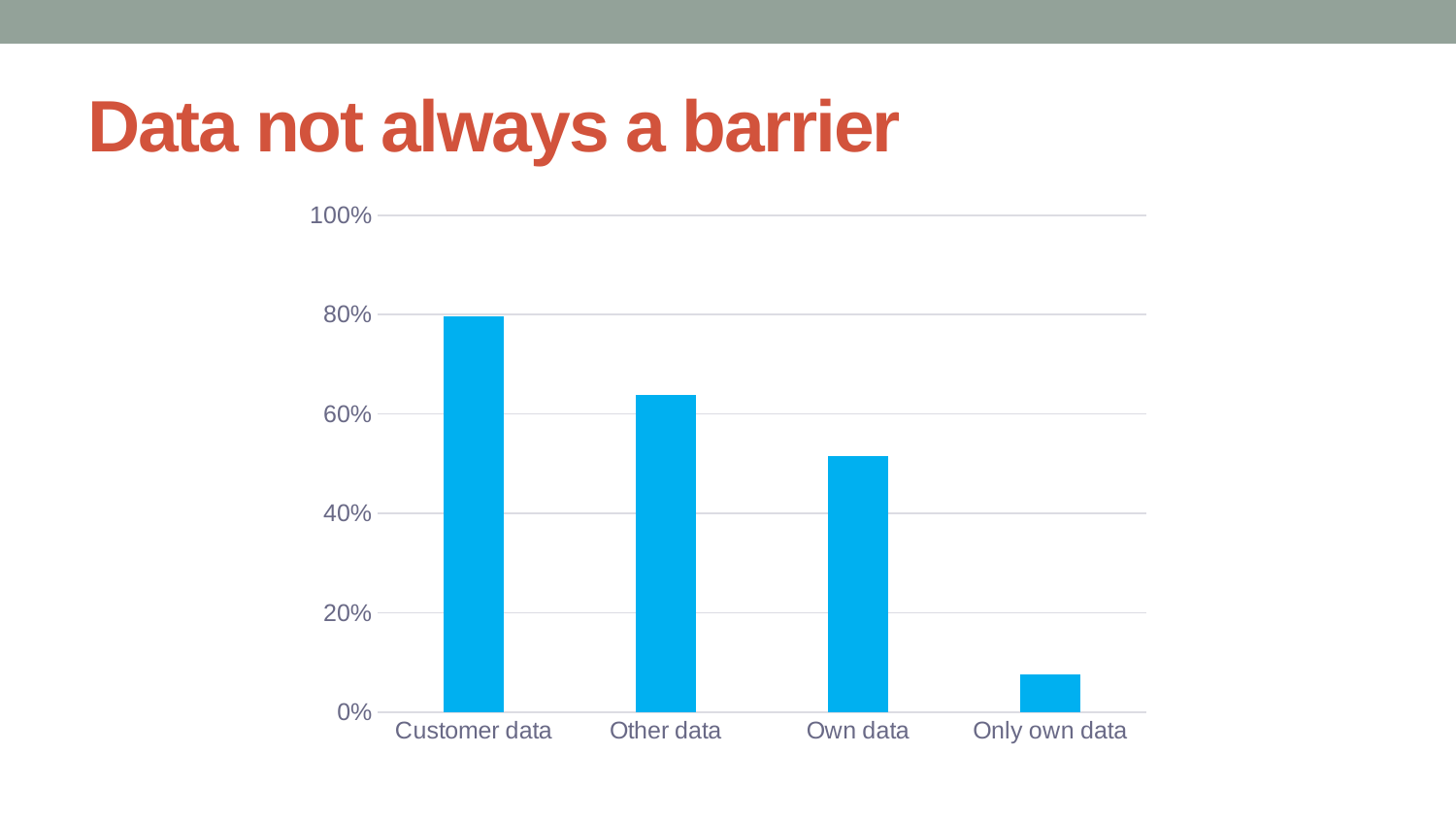
Which is larger, the value for Other data or the value for Own data? Other data What kind of chart is shown on the slide? bar chart Which category has the highest value? Customer data Is the value for Customer data greater or less than 60%? greater Is the value for Own data greater or less than 60%? less Which is larger, the value for Own data or the value for Only own data? Own data How many categories are shown on the x axis of the chart? 4 Is the value for Only own data greater or less than 20%? less Do the bar values rise or fall from left to right along the x axis? fall What is the title of the slide containing the chart? Data not always a barrier Which category has the lowest value? Only own data